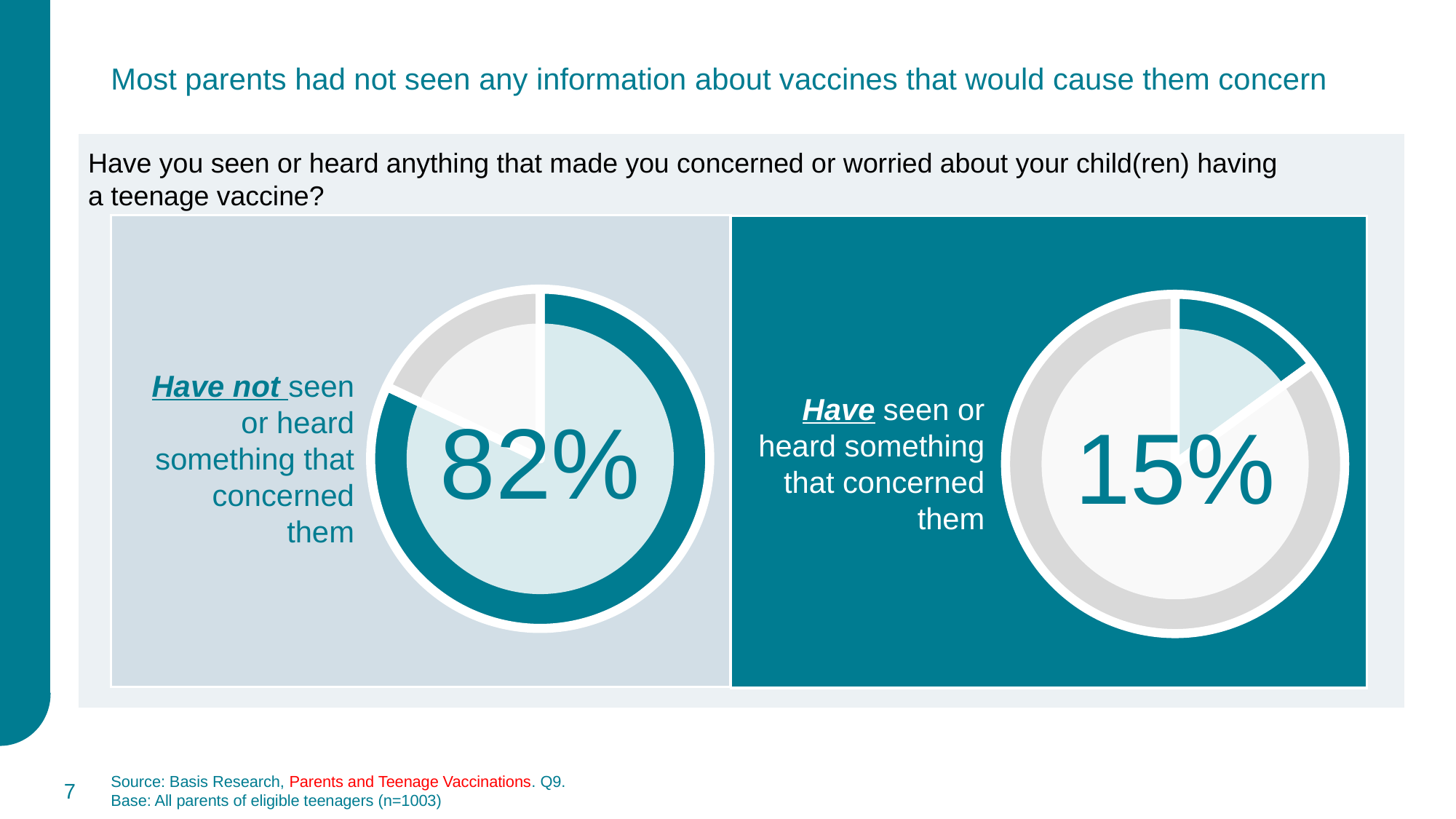
On the left chart, is the value for parents who have not seen something concerning greater or less than 50%? greater On the left chart, what share of the pie does the highlighted teal segment represent? 82% What survey question do the two charts on the slide answer? Have you seen or heard anything that made you concerned or worried about your child(ren) having a teenage vaccine? What is the difference in percentage points between the left chart's value (82%) and the right chart's value (15%)? 67 percentage points On the right chart, what share of the pie does the highlighted teal segment represent? 15% What kind of chart is used on the left side of the slide to show the 82% figure? Pie chart (donut) How many charts are shown on the slide? 2 On the right chart, is the value for parents who have seen something concerning greater or less than 50%? less Comparing the two charts, which is larger: the share who have not seen something concerning or the share who have seen something concerning? Have not seen What is the base size (n) stated for the charts on the slide? n=1003 On the left chart, what percentage of parents have not seen or heard something that concerned them? 82% On the right chart, what percentage of parents have seen or heard something that concerned them? 15%